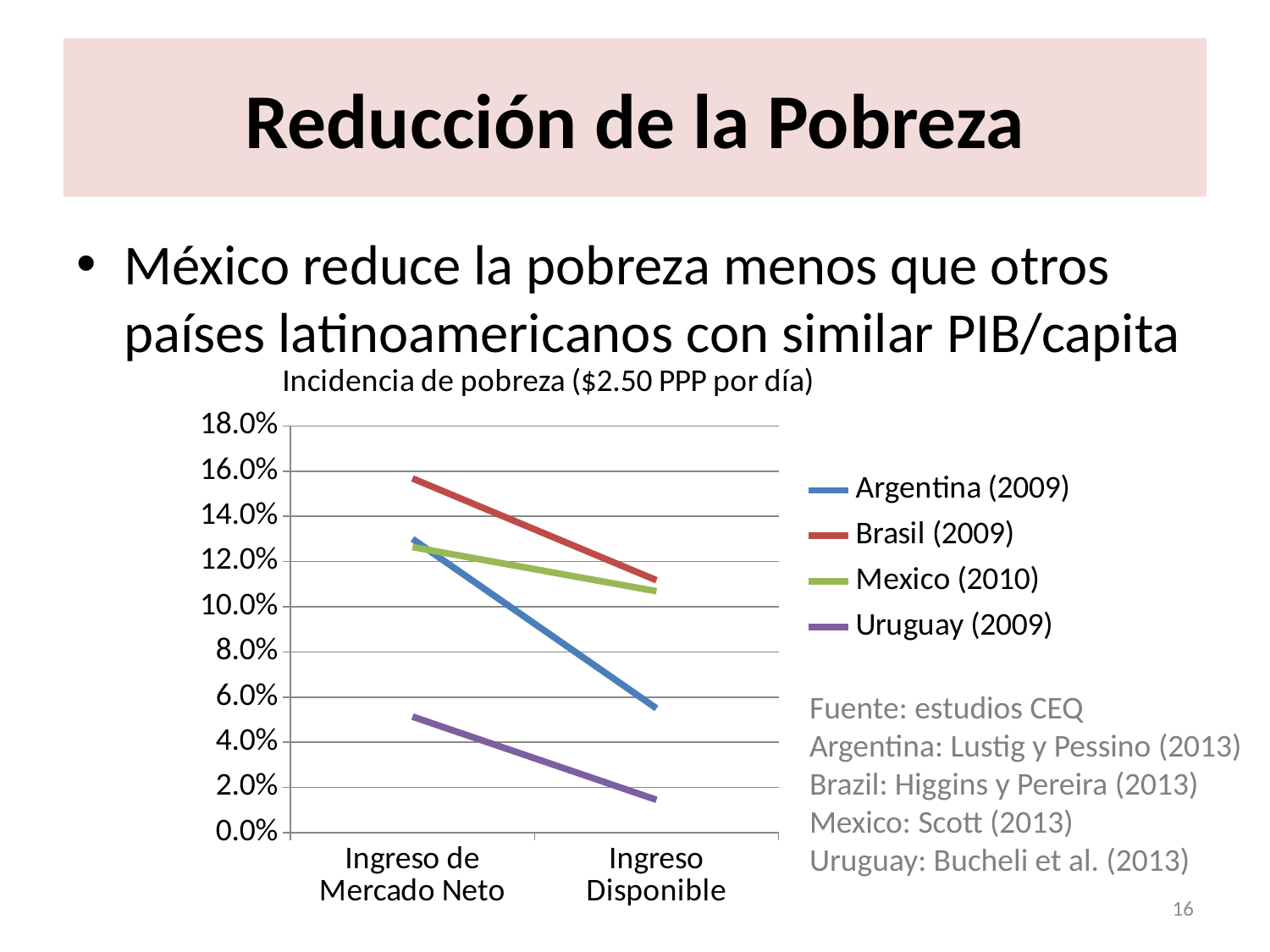
Which series has the highest value at Ingreso Disponible? Brasil (2009) What is the title of the chart? Incidencia de pobreza ($2.50 PPP por día) Is the value for Argentina (2009) at Ingreso Disponible greater or less than 8.0%? less How many categories are shown on the x axis? 2 Which series has the lowest value at Ingreso de Mercado Neto? Uruguay (2009) Which series has the lowest value at Ingreso Disponible? Uruguay (2009) Is the value for Uruguay (2009) at Ingreso Disponible greater or less than 2.0%? less At Ingreso Disponible, which is larger: the value for Mexico (2010) or the value for Argentina (2009)? Mexico (2010) What kind of chart is shown on the slide? Line chart How many series does the legend list? 4 Is the value for Brasil (2009) at Ingreso de Mercado Neto greater or less than 14.0%? greater Does the value for Argentina (2009) rise or fall from Ingreso de Mercado Neto to Ingreso Disponible? Fall